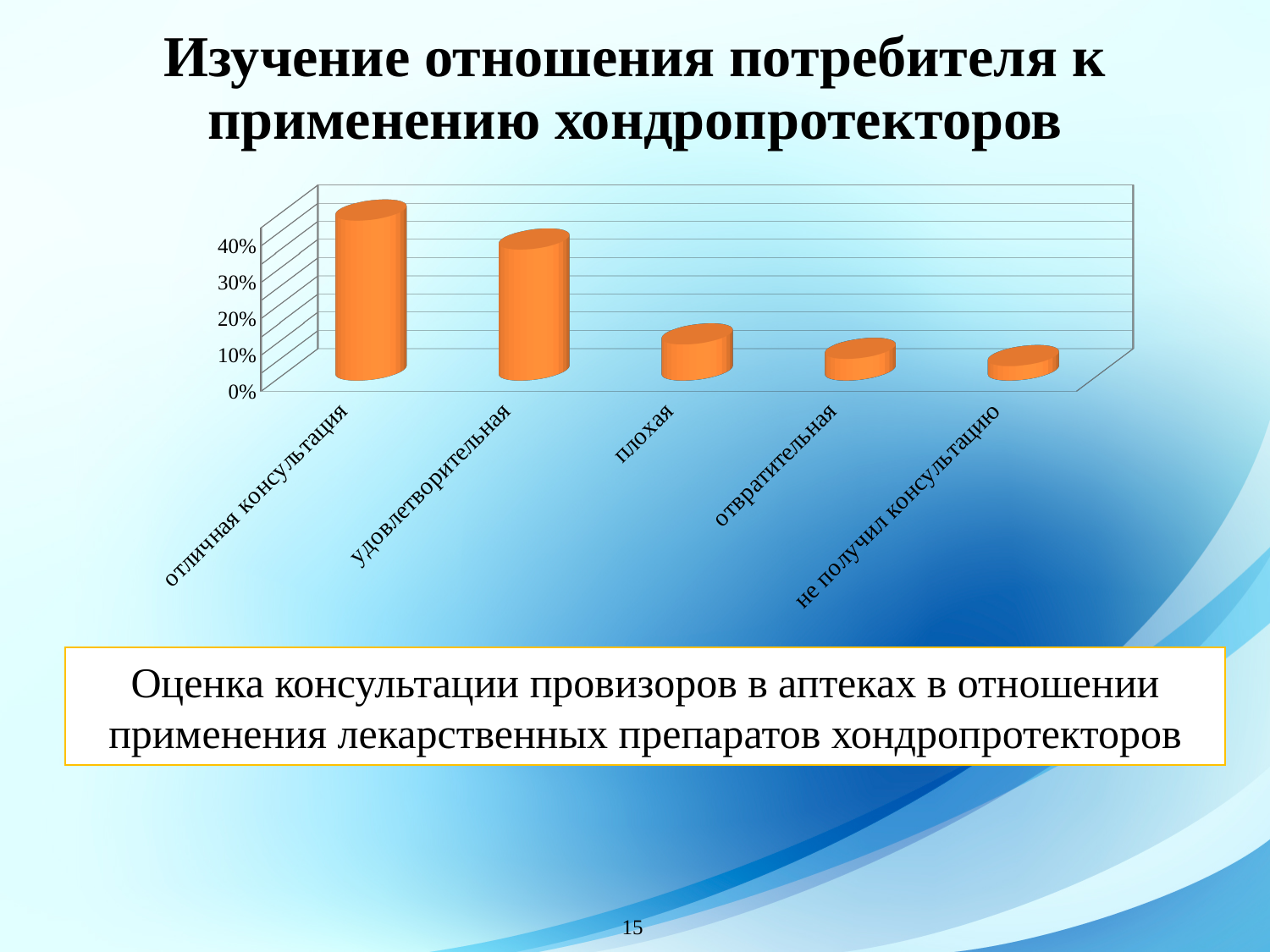
Which category has the highest value in the chart? отличная консультация Which category has the lowest value in the chart? не получил консультацию What kind of chart is shown on the slide? bar chart How many categories are shown on the x axis of the chart? 5 Is the value for плохая greater or less than 20%? less Do the values rise or fall moving from left to right along the x axis? fall Is the value for отличная консультация greater or less than 30%? greater Which is larger, the value for удовлетворительная or the value for плохая? удовлетворительная What is the highest percentage tick label shown on the vertical axis? 40% Is the value for отвратительная greater or less than 20%? less